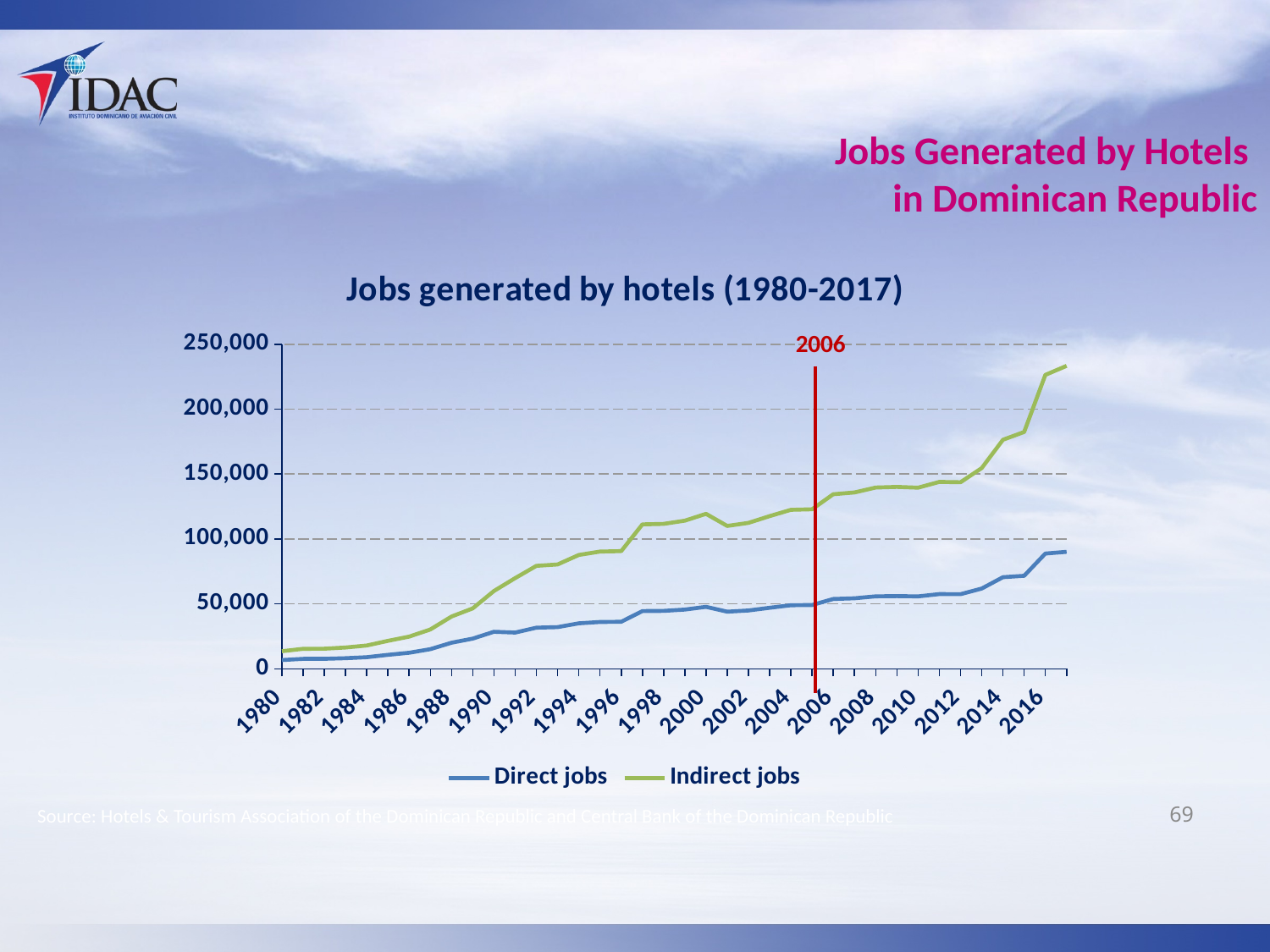
Is the value for Direct jobs in 2017 greater or less than 100,000? less What kind of chart is shown on the slide? line chart Is the value for Direct jobs in 2006 greater or less than 100,000? less What is the title of the chart? Jobs generated by hotels (1980-2017) Is the value for Indirect jobs in 2010 greater or less than 100,000? greater Do Indirect jobs generally rise or fall from 1980 to 2017? rise Which series has the highest value on the chart? Indirect jobs How many series does the legend list? 2 Which year is marked by the red vertical line on the chart? 2006 In 2016, which series has the larger value, Direct jobs or Indirect jobs? Indirect jobs